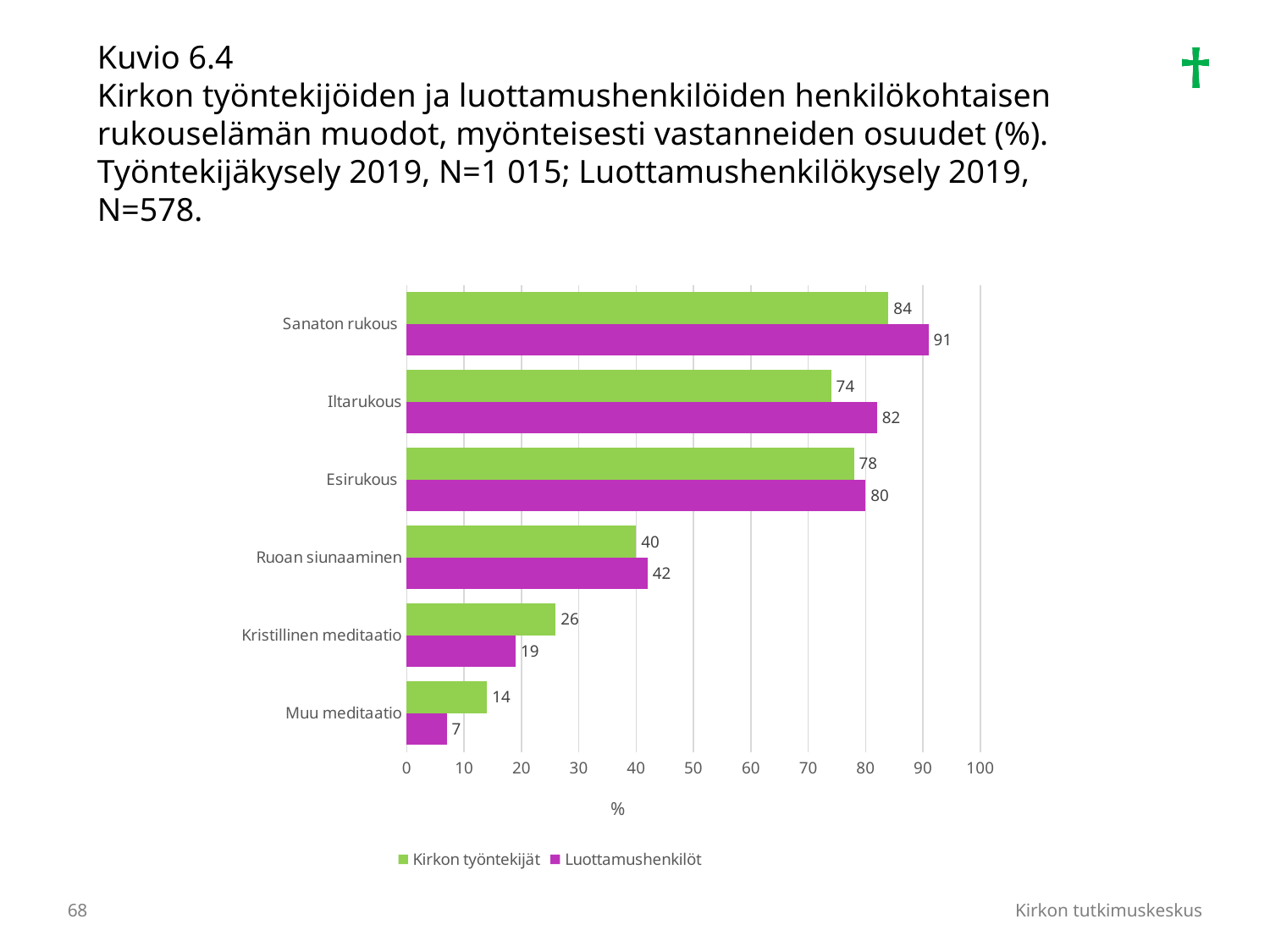
Which category has the lowest value for Kirkon työntekijät? Muu meditaatio Which category has the highest value for Luottamushenkilöt? Sanaton rukous How many categories are shown on the chart? 6 Is the value for Luottamushenkilöt for Ruoan siunaaminen greater or less than 50? less What is the difference between the Luottamushenkilöt and Kirkon työntekijät values for Sanaton rukous? 7 What is the value for Luottamushenkilöt for Iltarukous? 82 What is the value for Kirkon työntekijät for Sanaton rukous? 84 For Kristillinen meditaatio, which series has the larger value, Kirkon työntekijät or Luottamushenkilöt? Kirkon työntekijät What kind of chart is shown on the slide? bar chart How many series does the legend list? 2 What colour are the bars for Luottamushenkilöt? purple What is the value for Kirkon työntekijät for Kristillinen meditaatio? 26